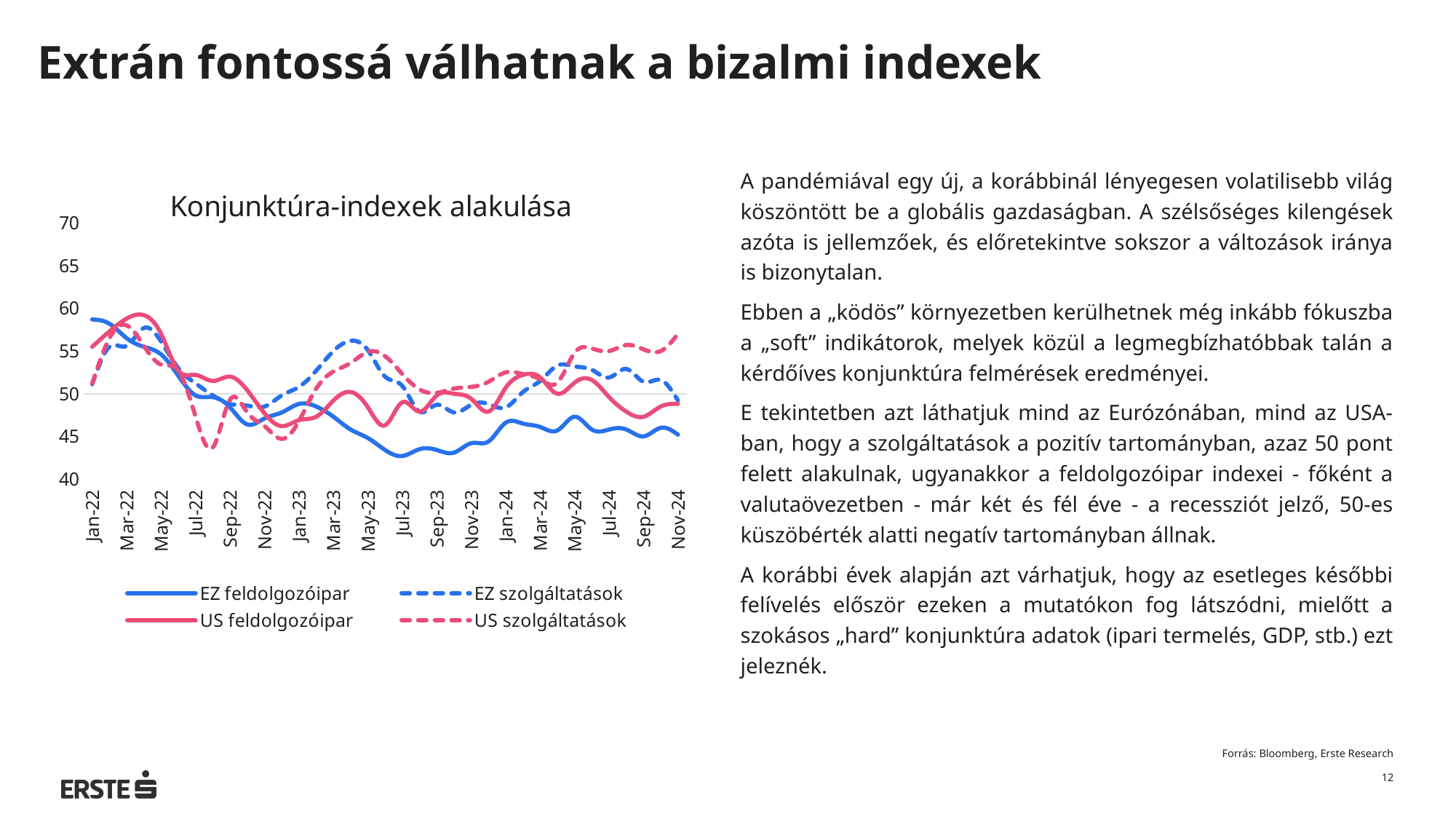
At Jul-23, which is higher: EZ szolgáltatások or EZ feldolgozóipar? EZ szolgáltatások Is the value for US szolgáltatások at Nov-24 greater or less than 55? greater How many series does the legend of the chart list? 4 What type of chart is shown on the slide? Line chart Does the EZ feldolgozóipar line overall rise or fall from Jan-22 to Nov-24? fall Is the value for EZ feldolgozóipar at Jan-22 greater or less than 55? greater Is the value for EZ feldolgozóipar at Nov-24 greater or less than 50? less Which series in the chart is drawn as a dashed blue line? EZ szolgáltatások Which series has the highest value at Nov-24? US szolgáltatások Which series has the lowest value at Nov-24? EZ feldolgozóipar What is the title of the chart? Konjunktúra-indexek alakulása